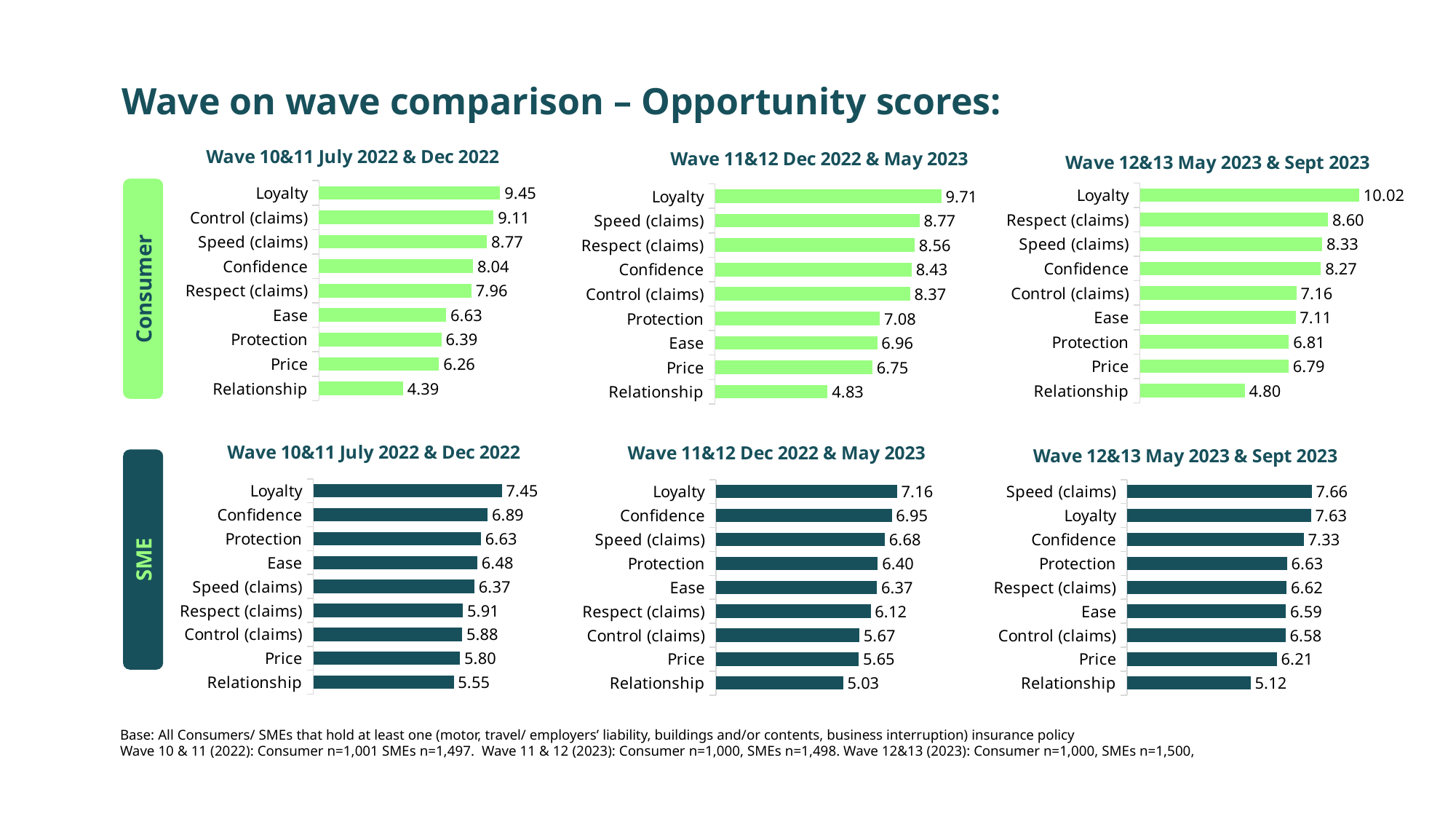
In the SME 'Wave 12&13 May 2023 & Sept 2023' chart, which category has the highest value? Speed (claims) In the Consumer 'Wave 10&11 July 2022 & Dec 2022' chart, what is the value for Loyalty? 9.45 In the SME 'Wave 10&11 July 2022 & Dec 2022' chart, what is the difference between Loyalty and Confidence? 0.56 In the SME 'Wave 11&12 Dec 2022 & May 2023' chart, what is the value for Protection? 6.40 How many categories are shown in the Consumer 'Wave 10&11 July 2022 & Dec 2022' chart? 9 In the Consumer 'Wave 11&12 Dec 2022 & May 2023' chart, which category has the lowest value? Relationship How many charts are shown on the slide? 6 In the SME 'Wave 11&12 Dec 2022 & May 2023' chart, which is larger: Speed (claims) or Ease? Speed (claims) What type of chart is used for the SME 'Wave 12&13 May 2023 & Sept 2023' data? Bar chart What colour are the bars in the SME charts? Dark teal In the Consumer 'Wave 12&13 May 2023 & Sept 2023' chart, what is the value for Respect (claims)? 8.60 In the Consumer 'Wave 12&13 May 2023 & Sept 2023' chart, what is the difference between Loyalty and Relationship? 5.22